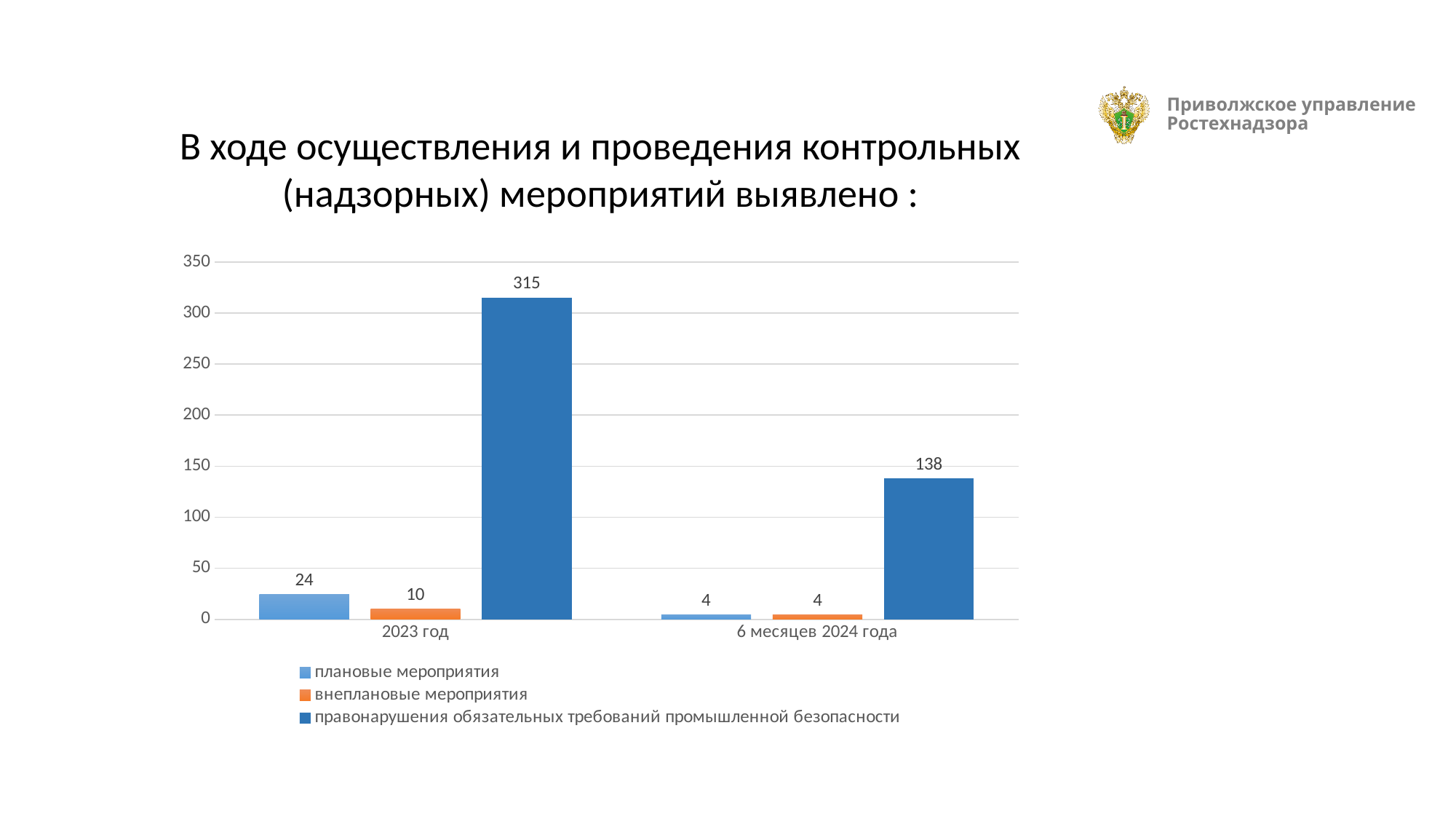
What is the value for внеплановые мероприятия in 2023 год? 10 How many categories are shown on the x axis? 2 What is the value for плановые мероприятия in 2023 год? 24 Which series has the lowest value in 2023 год? внеплановые мероприятия Is the value for правонарушения обязательных требований промышленной безопасности in 2023 год greater or less than 300? greater What is the value for правонарушения обязательных требований промышленной безопасности in 6 месяцев 2024 года? 138 Which series has the highest value in 2023 год? правонарушения обязательных требований промышленной безопасности What is the difference between правонарушения обязательных требований промышленной безопасности in 2023 год and in 6 месяцев 2024 года? 177 Which is larger: плановые мероприятия in 2023 год or плановые мероприятия in 6 месяцев 2024 года? 2023 год What kind of chart is shown on the slide? bar chart How many series does the legend list? 3 What colour are the bars for внеплановые мероприятия? orange